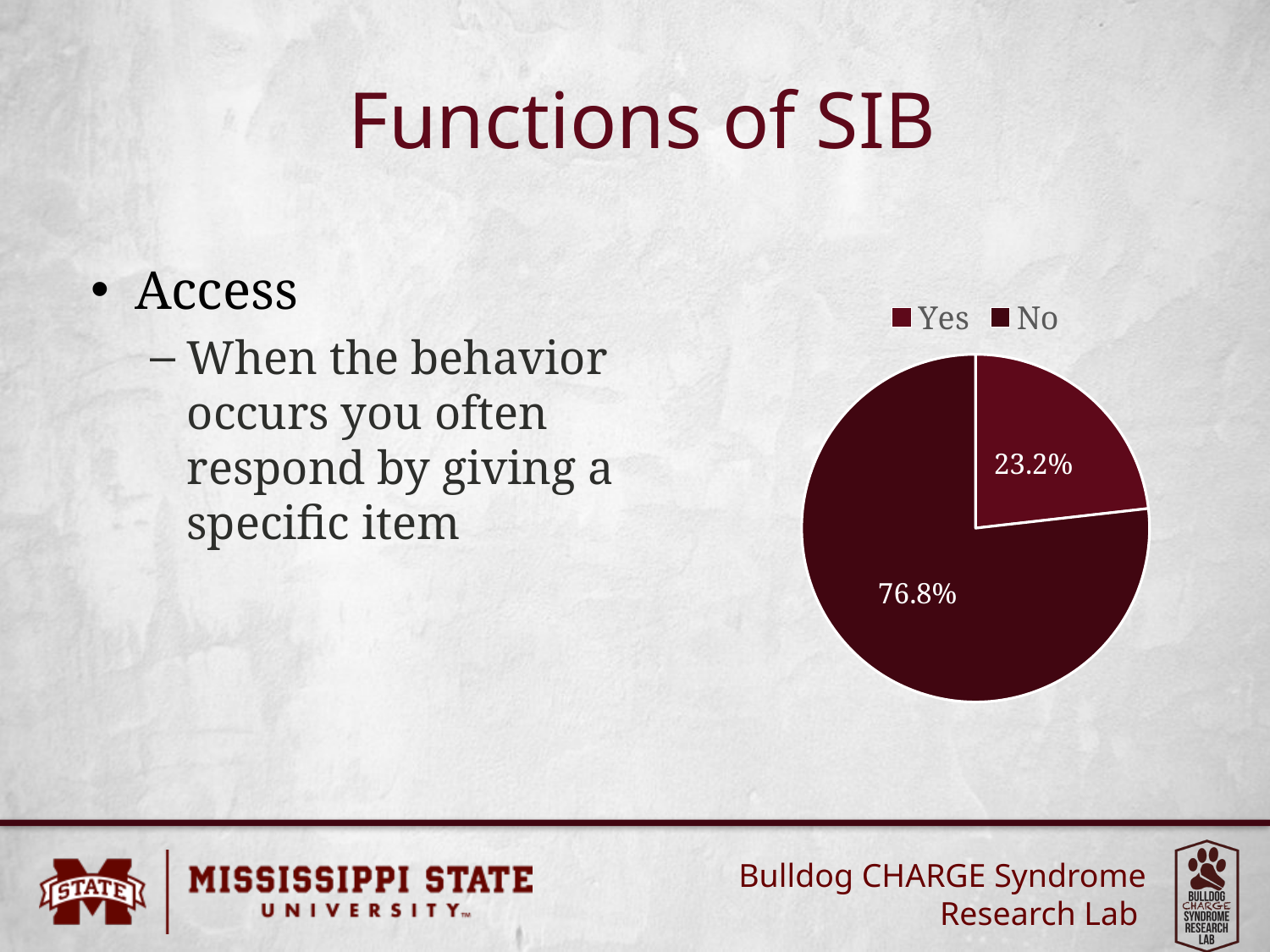
Which is larger, the "Yes" slice or the "No" slice? No What share of the pie does the "No" slice take up? 76.8% How many entries does the legend list? 2 How many slices does the pie chart have? 2 Which slice of the pie is the largest? No What is the difference in percentage points between the "No" slice and the "Yes" slice? 53.6 What kind of chart is shown on the slide? pie chart What percentage of the pie is labelled "Yes"? 23.2% Which slice of the pie is the smallest? Yes Where is the legend positioned relative to the pie? above the pie What are the two legend entries of the pie chart? Yes and No What percentage of the pie is labelled "No"? 76.8%